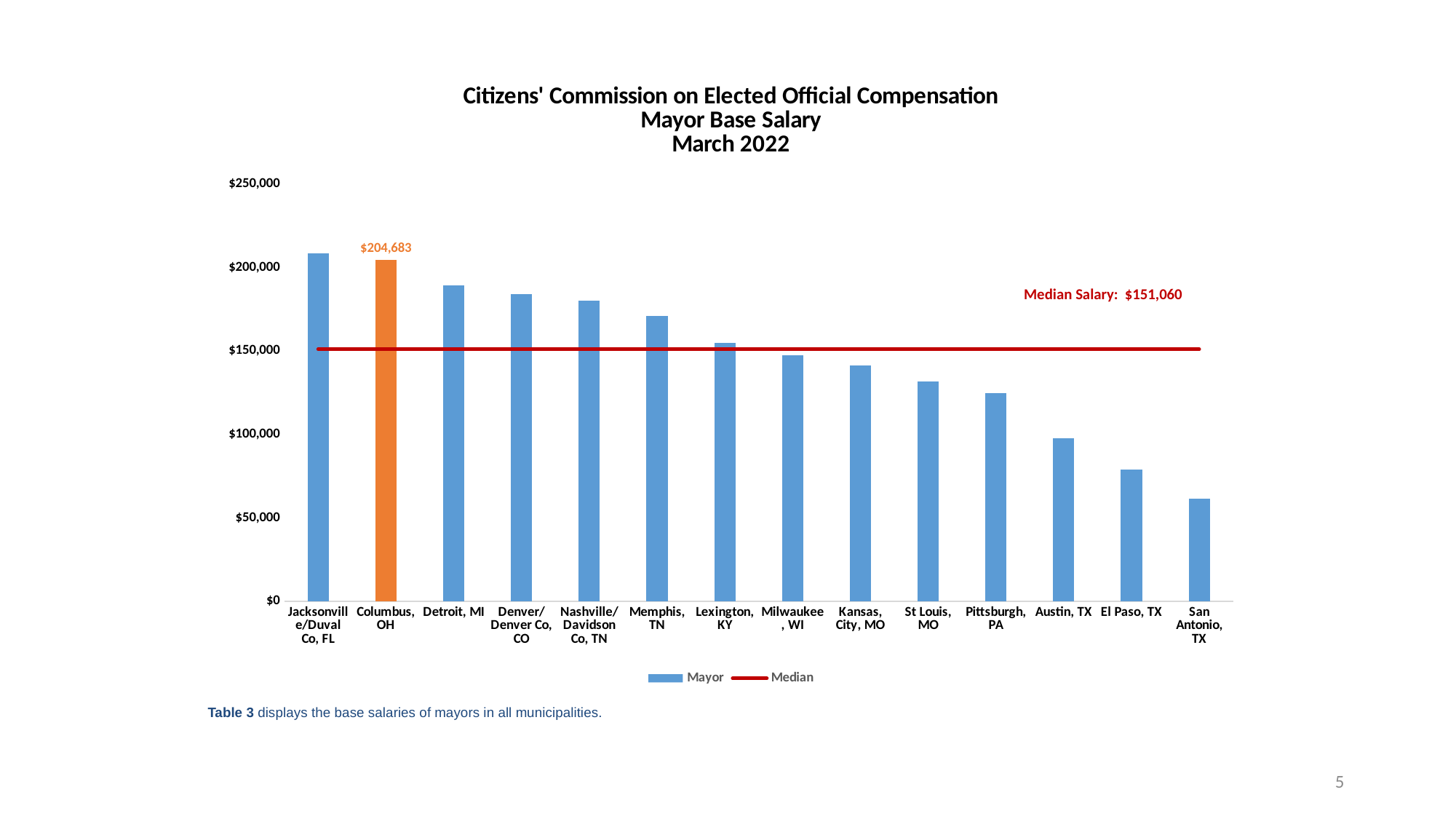
Which has the larger mayor base salary, Detroit, MI or Memphis, TN? Detroit, MI Do the mayor base salaries rise or fall from left to right across the chart? fall What median salary is printed on the chart? $151,060 How many entries does the chart legend list? 2 Is the value for Kansas City, MO greater or less than $150,000? less What is the mayor base salary shown for Columbus, OH? $204,683 Is the value for Pittsburgh, PA greater or less than $100,000? greater Which city has the lowest mayor base salary on the chart? San Antonio, TX What kind of chart is shown on the slide? bar chart Is the value for Detroit, MI greater or less than $150,000? greater How many cities are shown on the x axis of the chart? 14